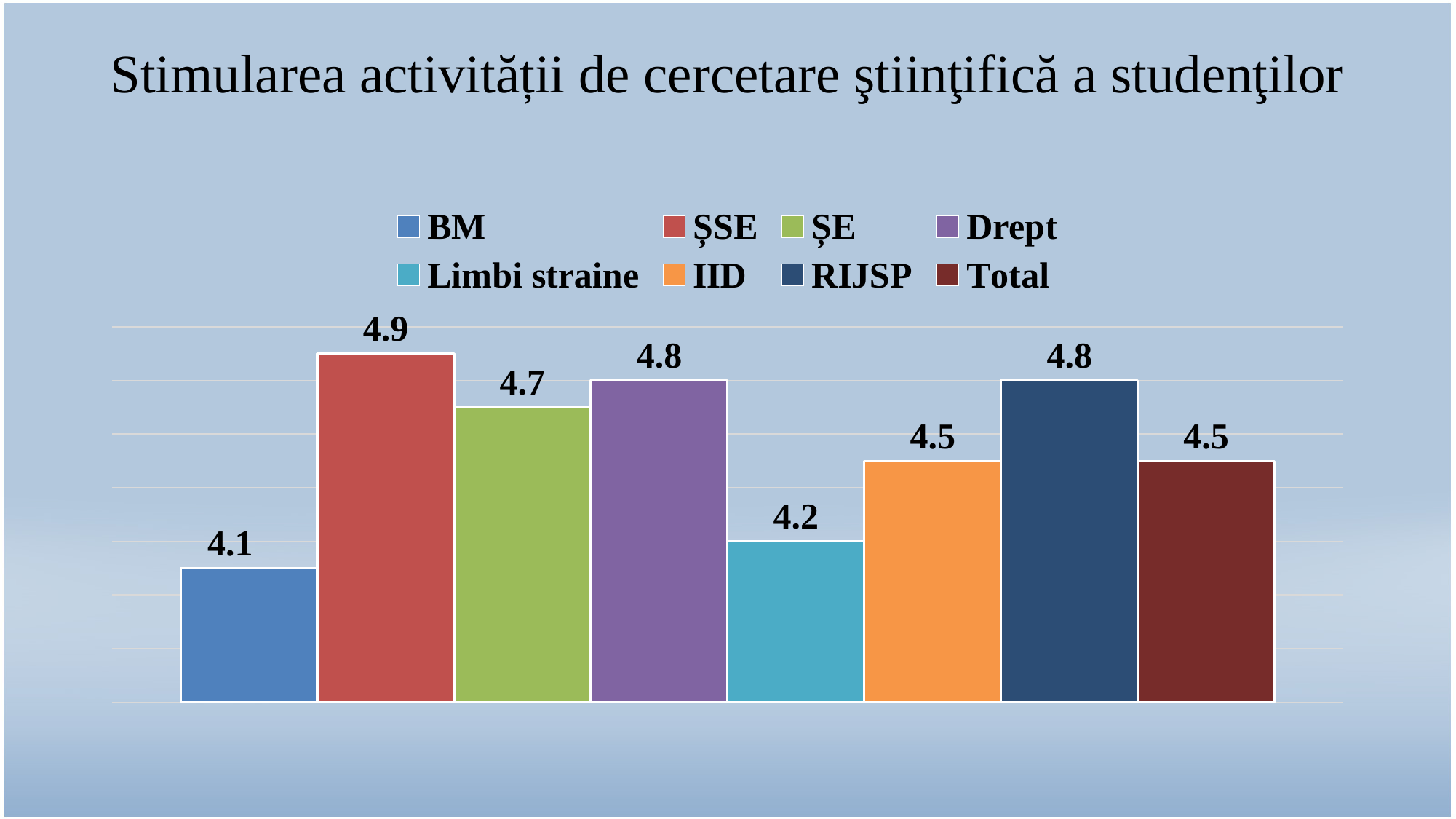
What is the difference between the values for Drept and IID? 0.3 What is the value for Limbi straine? 4.2 Which is larger, the value for ȘE or the value for Limbi straine? ȘE How many entries does the legend list? 8 What is the difference between the values for ȘSE and BM? 0.8 What is the value for ȘSE? 4.9 Which category has the highest value? ȘSE What is the value for Total? 4.5 What is the value for BM? 4.1 How many bars are plotted in the chart? 8 What kind of chart is shown on the slide? Bar chart Which category has the lowest value? BM